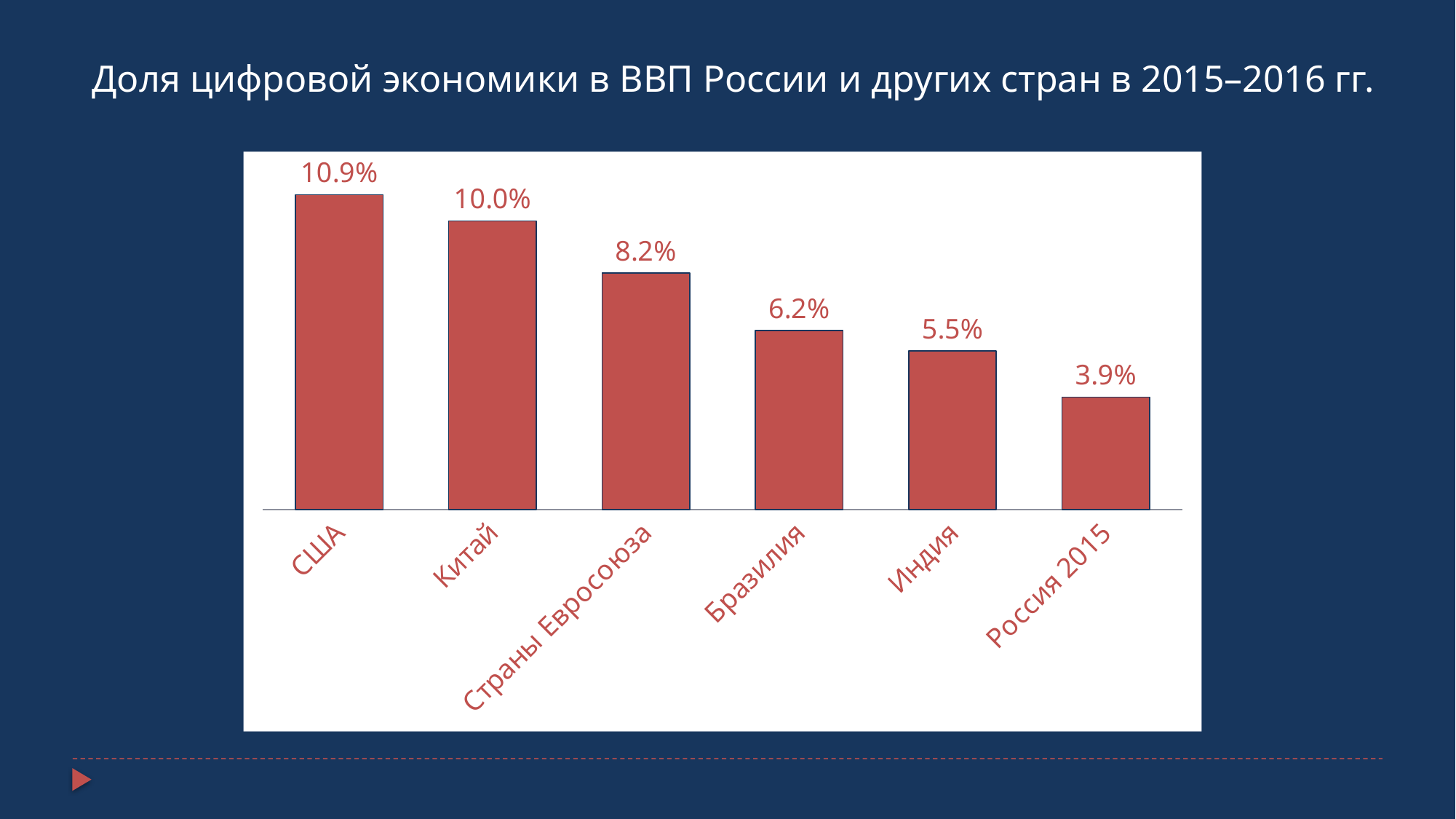
What is the value for США? 10.9% What is the difference between the values for США and Россия 2015? 7.0% Which category has the lowest value? Россия 2015 What is the value for Страны Евросоюза? 8.2% What is the value for Китай? 10.0% Which category has the highest value? США What is the difference between the values for Бразилия and Индия? 0.7% Which is larger, the value for Страны Евросоюза or the value for Бразилия? Страны Евросоюза How many categories are shown in the chart? 6 What is the value for Россия 2015? 3.9% What kind of chart is shown on the slide? bar chart Do the values rise or fall from left to right along the x axis? fall